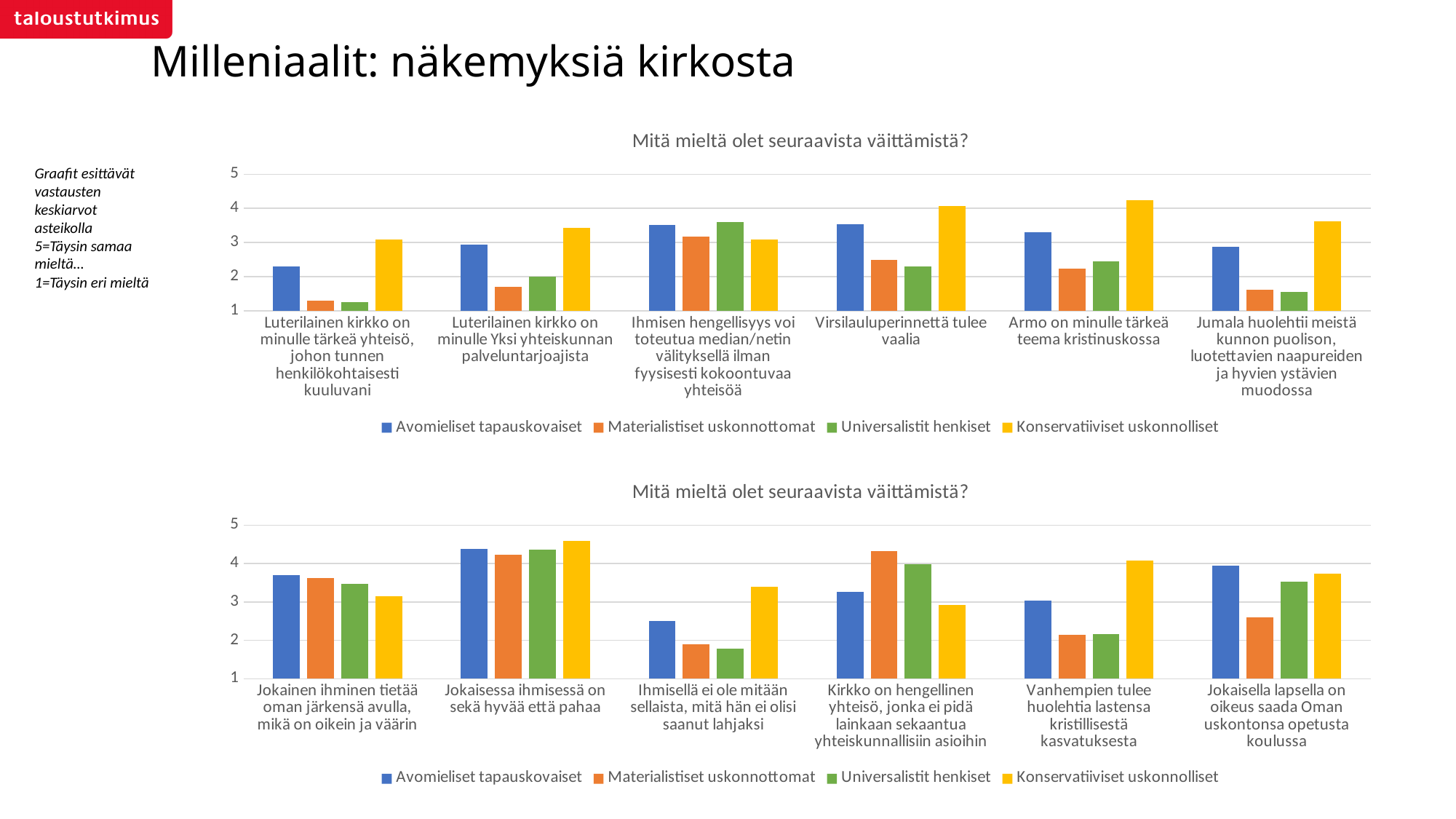
In the bottom chart, which group has the lowest value for 'Jokaisella lapsella on oikeus saada Oman uskontonsa opetusta koulussa'? Materialistiset uskonnottomat In the bottom chart, for 'Kirkko on hengellinen yhteisö, jonka ei pidä lainkaan sekaantua yhteiskunnallisiin asioihin', which is larger: Materialistiset uskonnottomat or Konservatiiviset uskonnolliset? Materialistiset uskonnottomat In the top chart, which group has the highest value for 'Virsilauluperinnettä tulee vaalia'? Konservatiiviset uskonnolliset What kind of chart is the top chart on the slide? bar chart In the bottom chart, which group has the highest value for 'Kirkko on hengellinen yhteisö, jonka ei pidä lainkaan sekaantua yhteiskunnallisiin asioihin'? Materialistiset uskonnottomat In the top chart, is the value of Konservatiiviset uskonnolliset for 'Armo on minulle tärkeä teema kristinuskossa' greater or less than 4? greater In the top chart, which group has the lowest value for 'Luterilainen kirkko on minulle Yksi yhteiskunnan palveluntarjoajista'? Materialistiset uskonnottomat How many series does the legend of the bottom chart list? 4 What colour are the bars for Konservatiiviset uskonnolliset in both charts? yellow In the top chart, is the value of Materialistiset uskonnottomat for 'Luterilainen kirkko on minulle tärkeä yhteisö, johon tunnen henkilökohtaisesti kuuluvani' greater or less than 2? less How many statements (categories) are shown on the x axis of the top chart? 6 In the bottom chart, is the value of Universalistit henkiset for 'Ihmisellä ei ole mitään sellaista, mitä hän ei olisi saanut lahjaksi' greater or less than 2? less